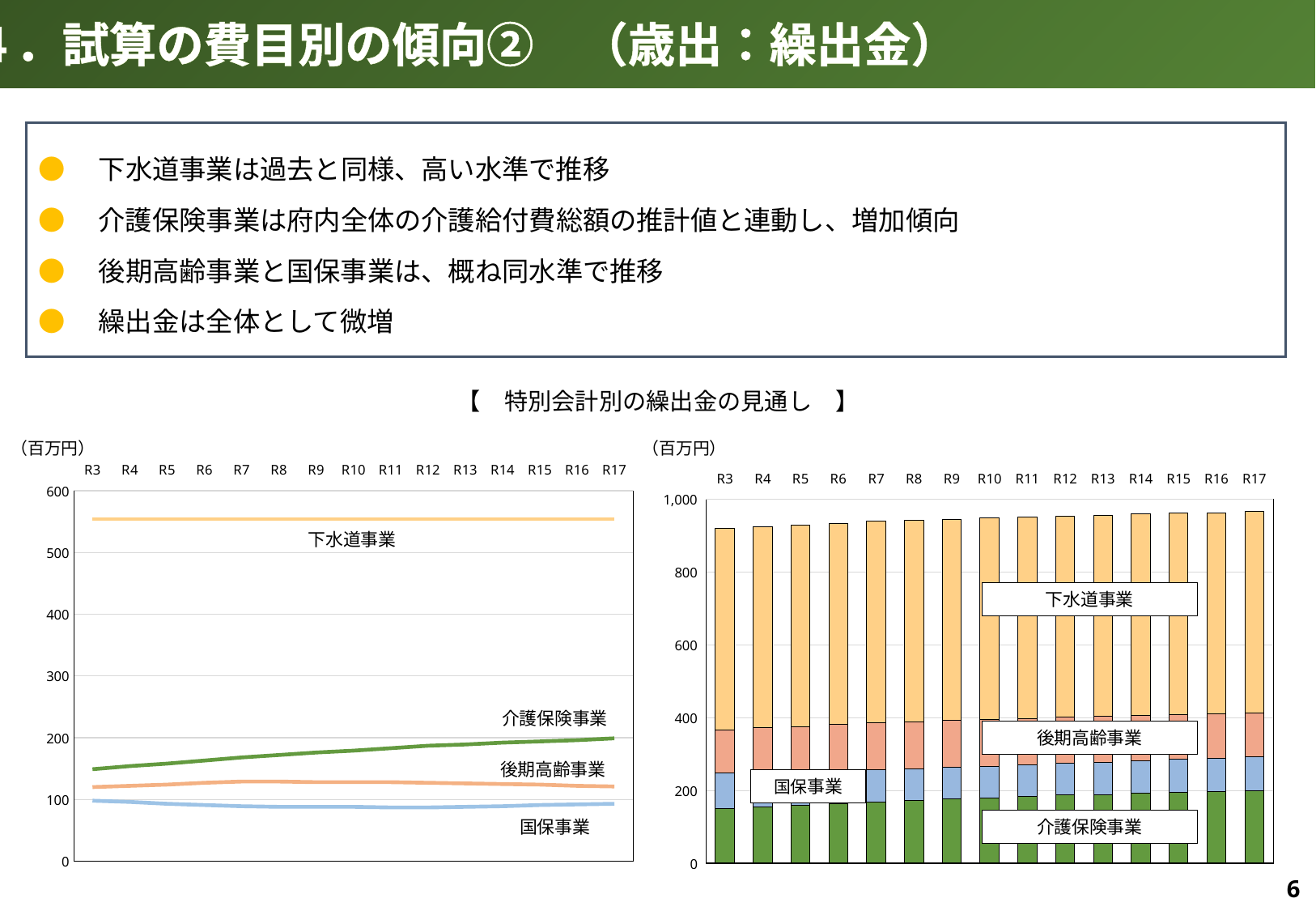
What kind of chart is the right chart on the slide? bar chart In the left chart, is the value for 介護保険事業 at R17 greater or less than 300? less In the left chart, which series has the lowest values? 国保事業 In the right chart, how many stacked bars are there? 15 In the left chart, which series has the highest values? 下水道事業 In the left chart, how many fiscal years are plotted along the x axis? 15 In the left chart, is the value for 下水道事業 at R3 greater or less than 500? greater What kind of chart is the left chart on the slide? line chart In the right chart, is the 介護保険事業 segment larger at R3 or at R17? R17 What unit is shown above the y axis of both charts? 百万円 In the right chart, is the total of the stacked bar for R17 greater or less than 800? greater In the left chart, does the 介護保険事業 line rise or fall from R3 to R17? rise